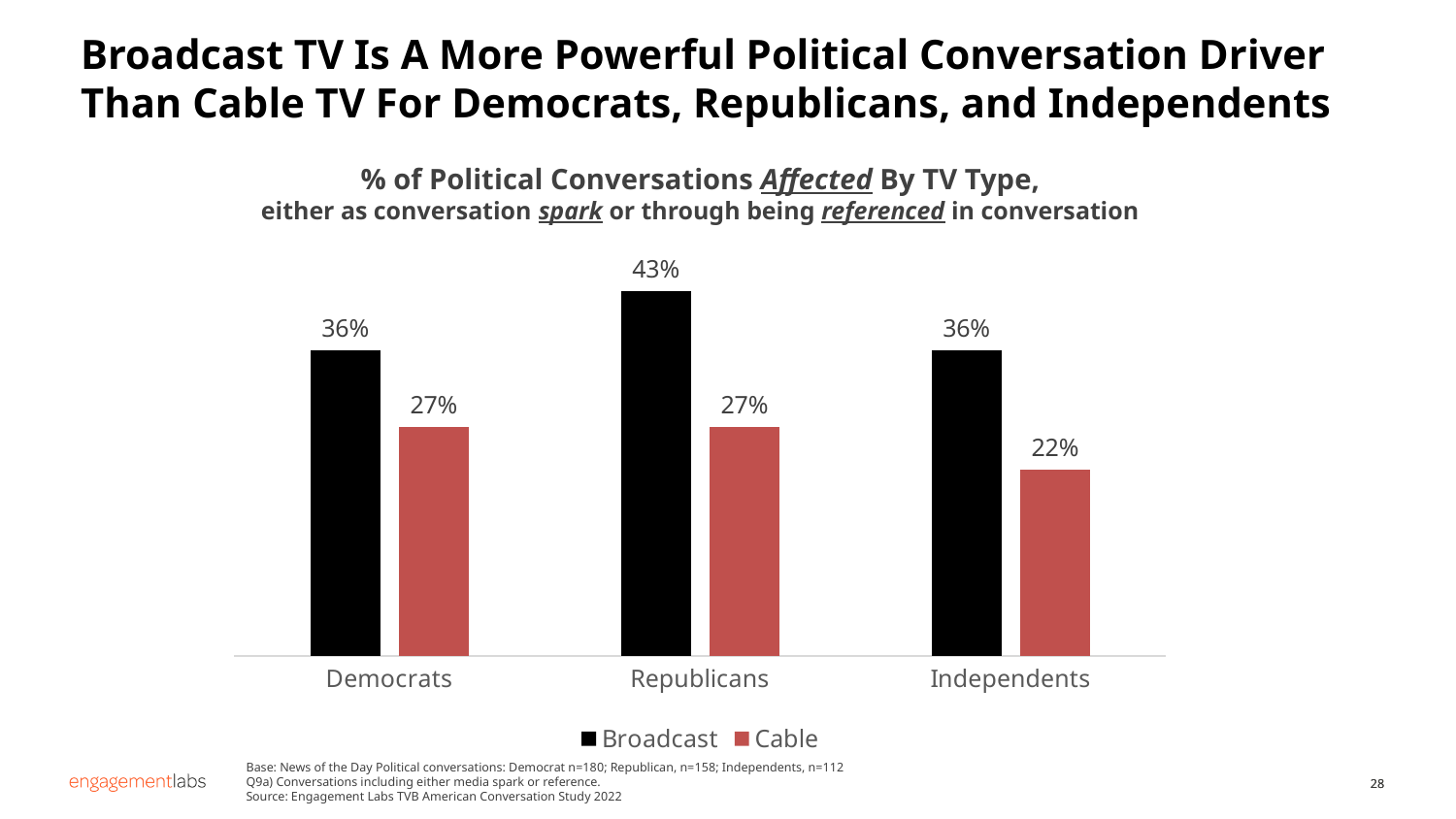
How many categories are shown on the x axis? 3 What is the Broadcast value for Democrats? 36% Which category has the highest Broadcast value? Republicans What is the Cable value for Independents? 22% What is the Broadcast value for Republicans? 43% Which is larger for Democrats, the Broadcast value or the Cable value? Broadcast What kind of chart is shown on the slide? Bar chart How many series does the legend list? 2 Which category has the lowest Cable value? Independents Which colour represents the Cable series in the legend? Red What is the difference between the Broadcast and Cable values for Independents? 14% What is the difference between the Broadcast and Cable values for Republicans? 16%